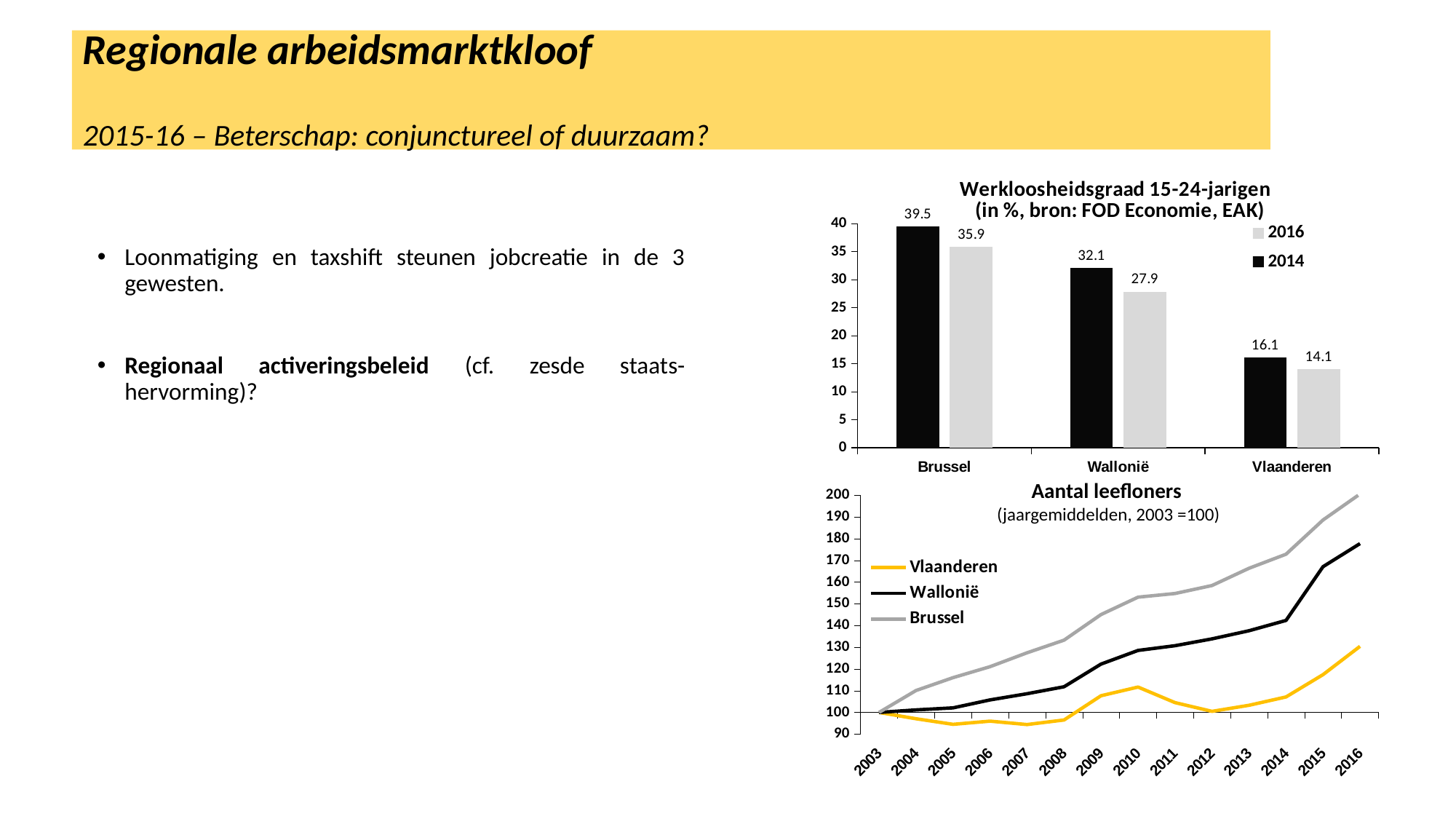
What kind of chart is the 'Werkloosheidsgraad 15-24-jarigen' chart? Bar chart In the 'Werkloosheidsgraad 15-24-jarigen' chart, which region has the lowest value in 2014? Vlaanderen In the 'Aantal leefloners' chart, which series has the highest value in 2016? Brussel In the 'Werkloosheidsgraad 15-24-jarigen' chart, what is the value for Vlaanderen in 2016? 14.1 In the 'Werkloosheidsgraad 15-24-jarigen' chart, what is the difference between the 2014 and 2016 values for Wallonië? 4.2 In the 'Werkloosheidsgraad 15-24-jarigen' chart, what is the value for Brussel in 2014? 39.5 In the 'Werkloosheidsgraad 15-24-jarigen' chart, how many series does the legend list? 2 In the 'Aantal leefloners' chart, does the Wallonië series rise or fall from 2003 to 2016? Rise In the 'Werkloosheidsgraad 15-24-jarigen' chart, which region has the highest value in 2016? Brussel In the 'Aantal leefloners' chart, is the value for Brussel in 2016 greater or less than 190? greater In the 'Aantal leefloners' chart, how many series does the legend list? 3 In the 'Aantal leefloners' chart, which colour is used for the Vlaanderen line? Yellow